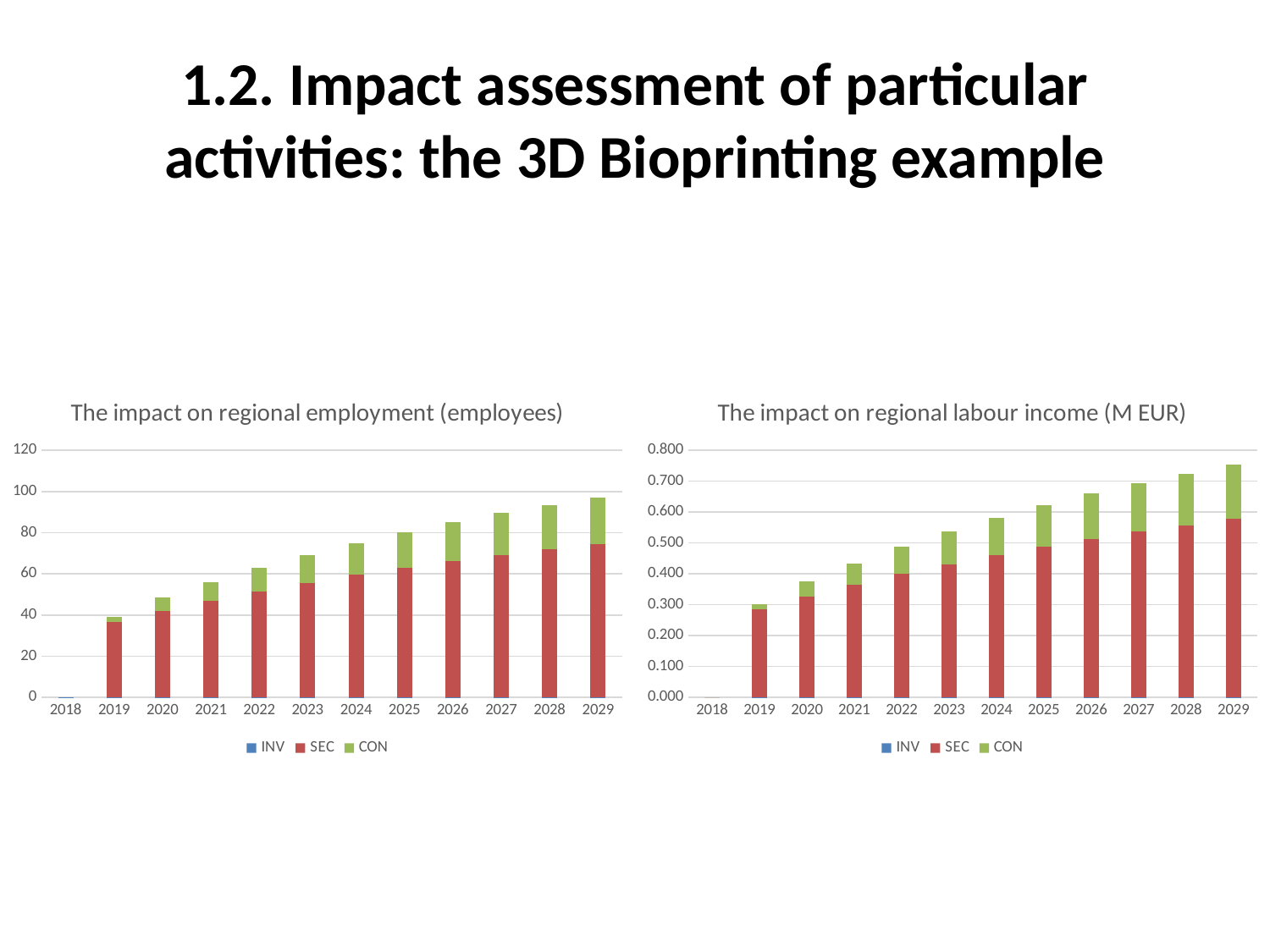
How many years are shown on the x axis of 'The impact on regional employment (employees)'? 12 In 'The impact on regional employment (employees)', is the total bar for 2024 greater or less than 60? greater In 'The impact on regional labour income (M EUR)', is the total bar for 2021 greater or less than 0.500? less In 'The impact on regional employment (employees)', is the total bar for 2029 greater or less than 80? greater Which series is shown in green in the legend of 'The impact on regional employment (employees)'? CON What kind of chart is 'The impact on regional employment (employees)'? stacked bar chart How many series does the legend list in 'The impact on regional labour income (M EUR)'? 3 In 'The impact on regional employment (employees)', which year has the larger total bar, 2022 or 2028? 2028 In 'The impact on regional employment (employees)', which year has the highest total bar? 2029 In 'The impact on regional labour income (M EUR)', which year has the lowest total bar? 2018 In 'The impact on regional labour income (M EUR)', do the total bars rise or fall from 2019 to 2029? rise